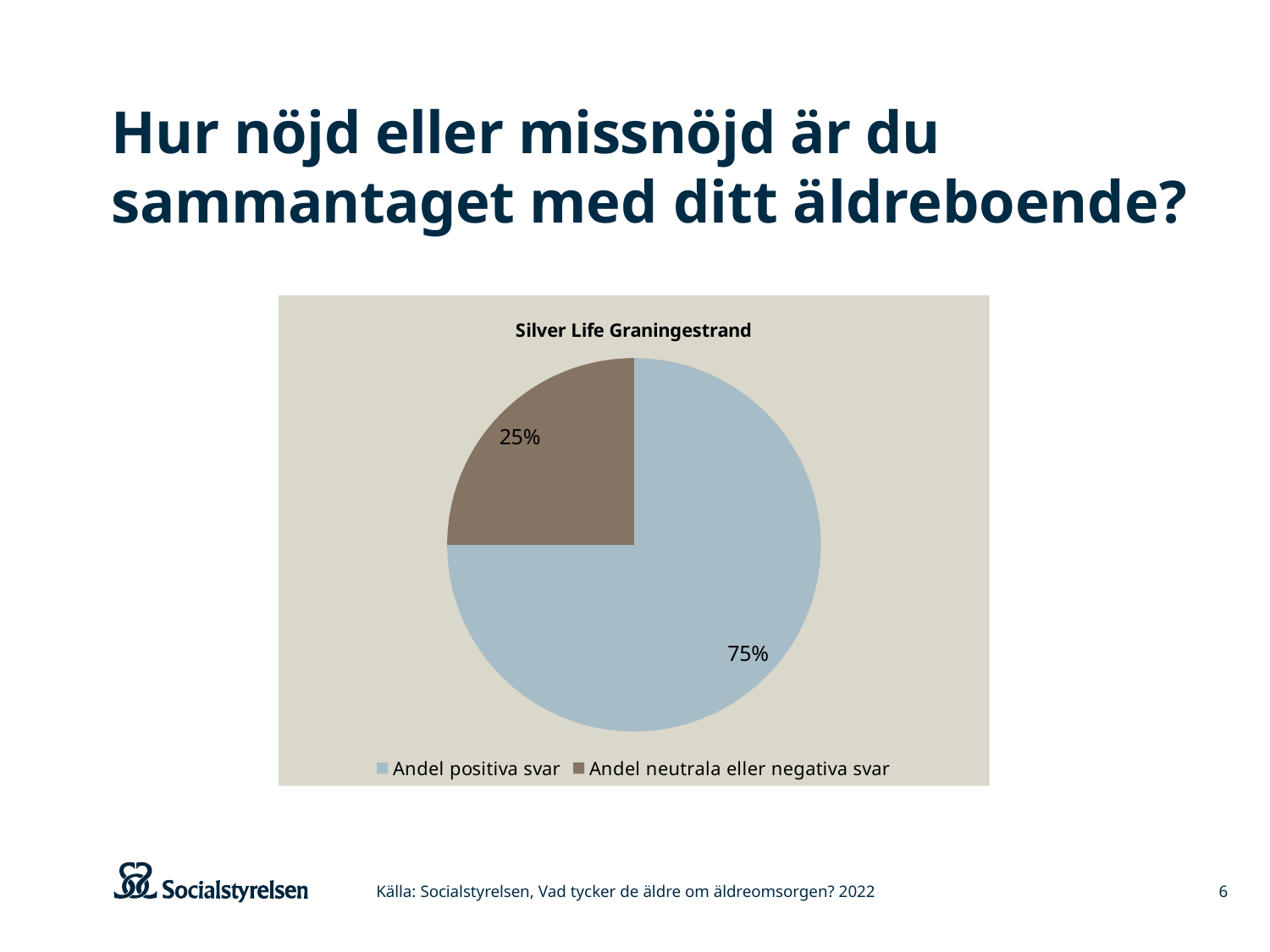
How many slices does the pie chart have? 2 What share of the pie is 'Andel positiva svar'? 75% Which slice is the smallest? Andel neutrala eller negativa svar What colour is the 'Andel neutrala eller negativa svar' slice? brown Which slice is the largest? Andel positiva svar What kind of chart is shown on the slide? pie chart What is the title of the chart? Silver Life Graningestrand What share of the pie is 'Andel neutrala eller negativa svar'? 25% Which is larger, 'Andel positiva svar' or 'Andel neutrala eller negativa svar'? Andel positiva svar How many entries does the legend list? 2 What is the difference in percentage points between 'Andel positiva svar' and 'Andel neutrala eller negativa svar'? 50 percentage points